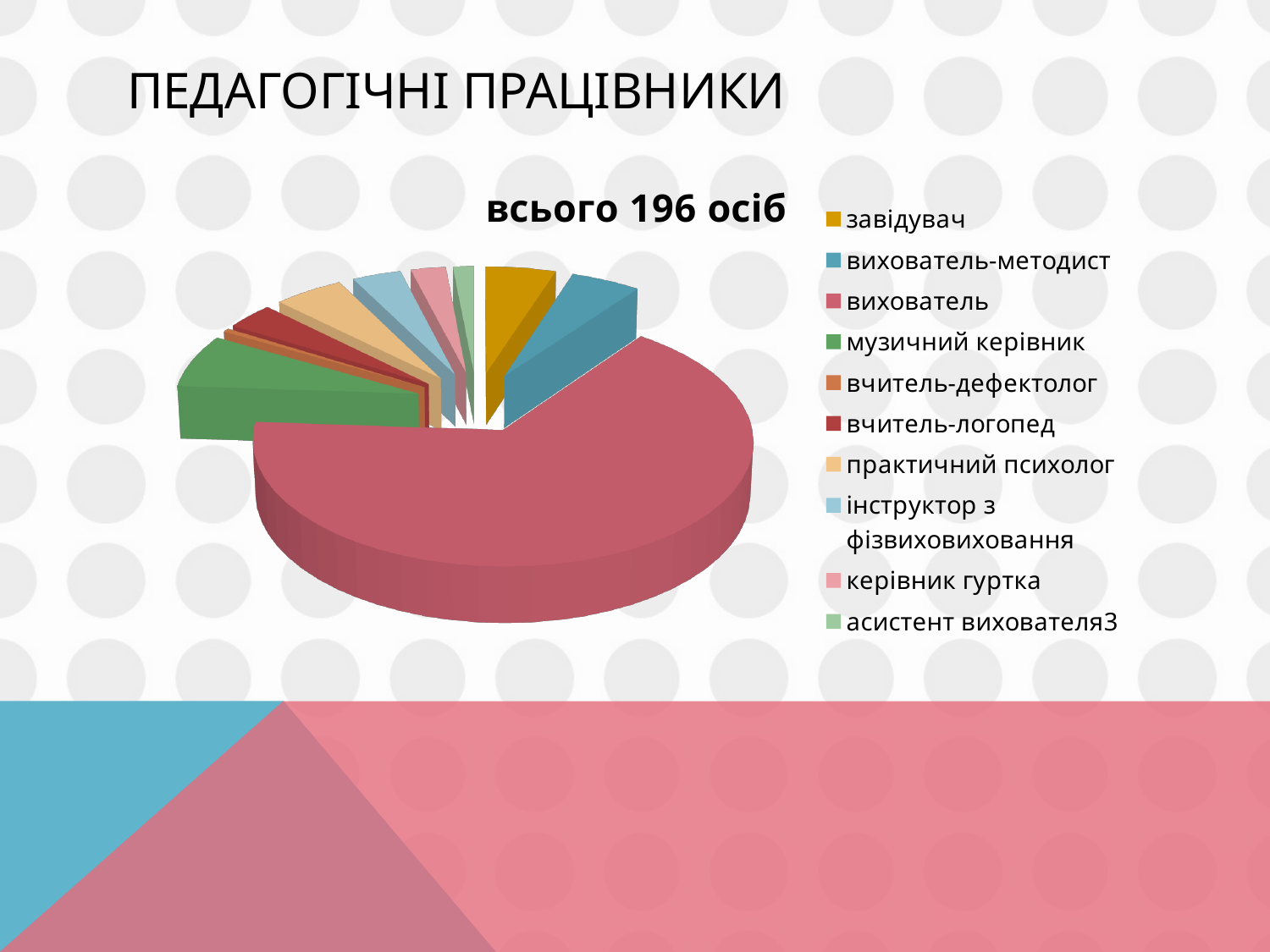
Which slice is larger: вихователь-методист or керівник гуртка? вихователь-методист How many categories does the chart's legend list? 10 What colour is the slice for вихователь? red Which category has the largest slice of the pie? вихователь What is the title of the chart? всього 196 осіб Does the slice for вихователь take up more or less than half of the pie? more Which slice is larger: музичний керівник or вчитель-дефектолог? музичний керівник What kind of chart is shown on the slide? pie chart Which slice is larger: вихователь or музичний керівник? вихователь